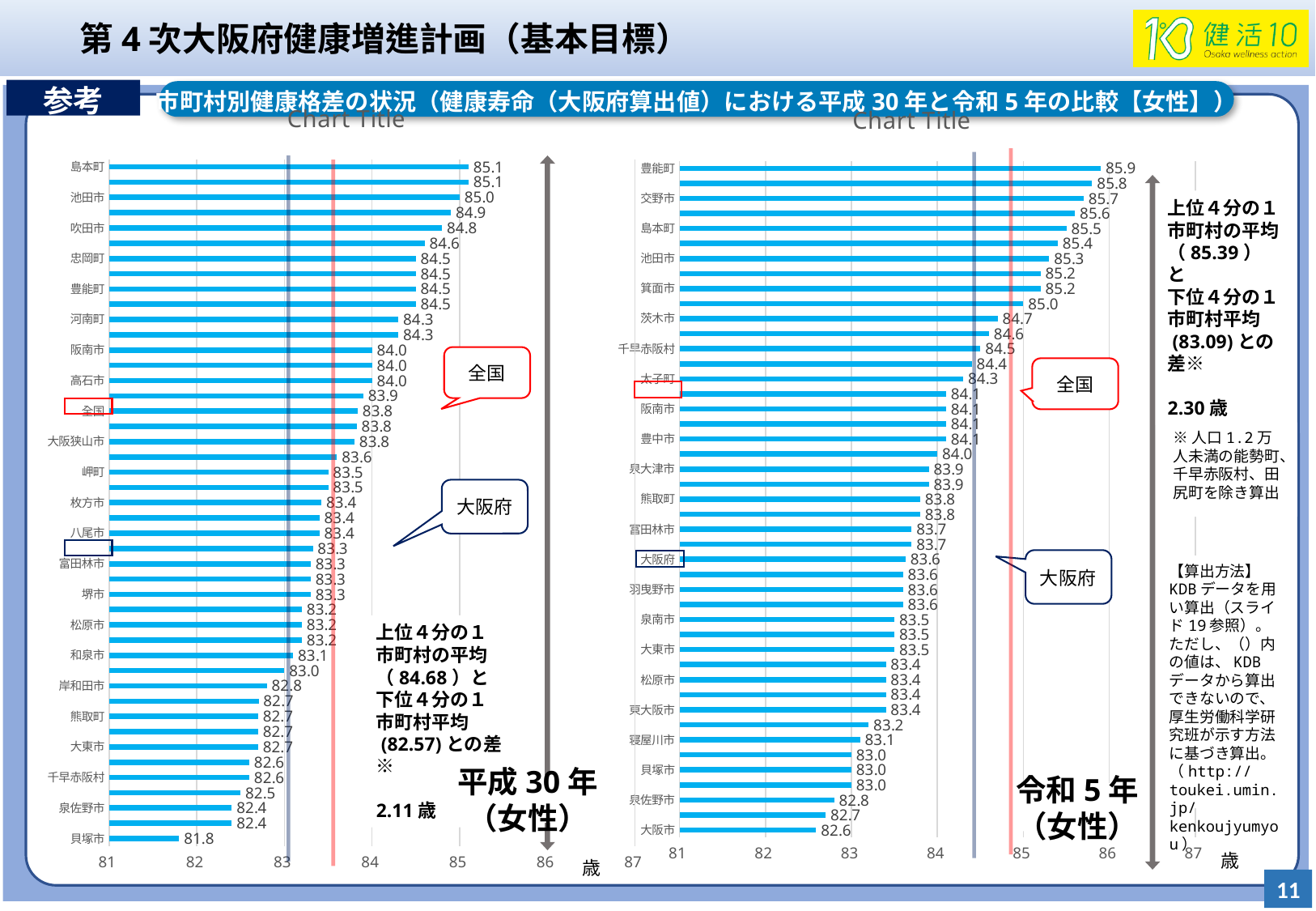
In the 令和5年（女性） chart on the right, what is the value for 大阪市? 82.6 According to the annotation next to the 令和5年（女性） chart, what is the difference between the average of the top quarter of municipalities and the average of the bottom quarter? 2.30歳 In the 平成30年（女性） chart on the left, what is the value for 島本町? 85.1 What kind of chart is used on the slide for the 平成30年（女性） data? bar chart Which is larger: the value for 池田市 in the 平成30年（女性） chart or the value for 池田市 in the 令和5年（女性） chart? 令和5年（女性） chart In the 平成30年（女性） chart on the left, what is the difference between the values for 島本町 and 貝塚市? 3.3 In the 平成30年（女性） chart on the left, what is the value for 貝塚市? 81.8 In the 平成30年（女性） chart on the left, which municipality has the lowest value? 貝塚市 In the 令和5年（女性） chart on the right, what is the difference between the values for 豊能町 and 大阪市? 3.3 In the 令和5年（女性） chart on the right, is the value for 大阪市 greater or less than 83? less In the 令和5年（女性） chart on the right, do the bar values rise or fall going from the top of the chart to the bottom? fall In the 令和5年（女性） chart on the right, which municipality has the highest value? 豊能町